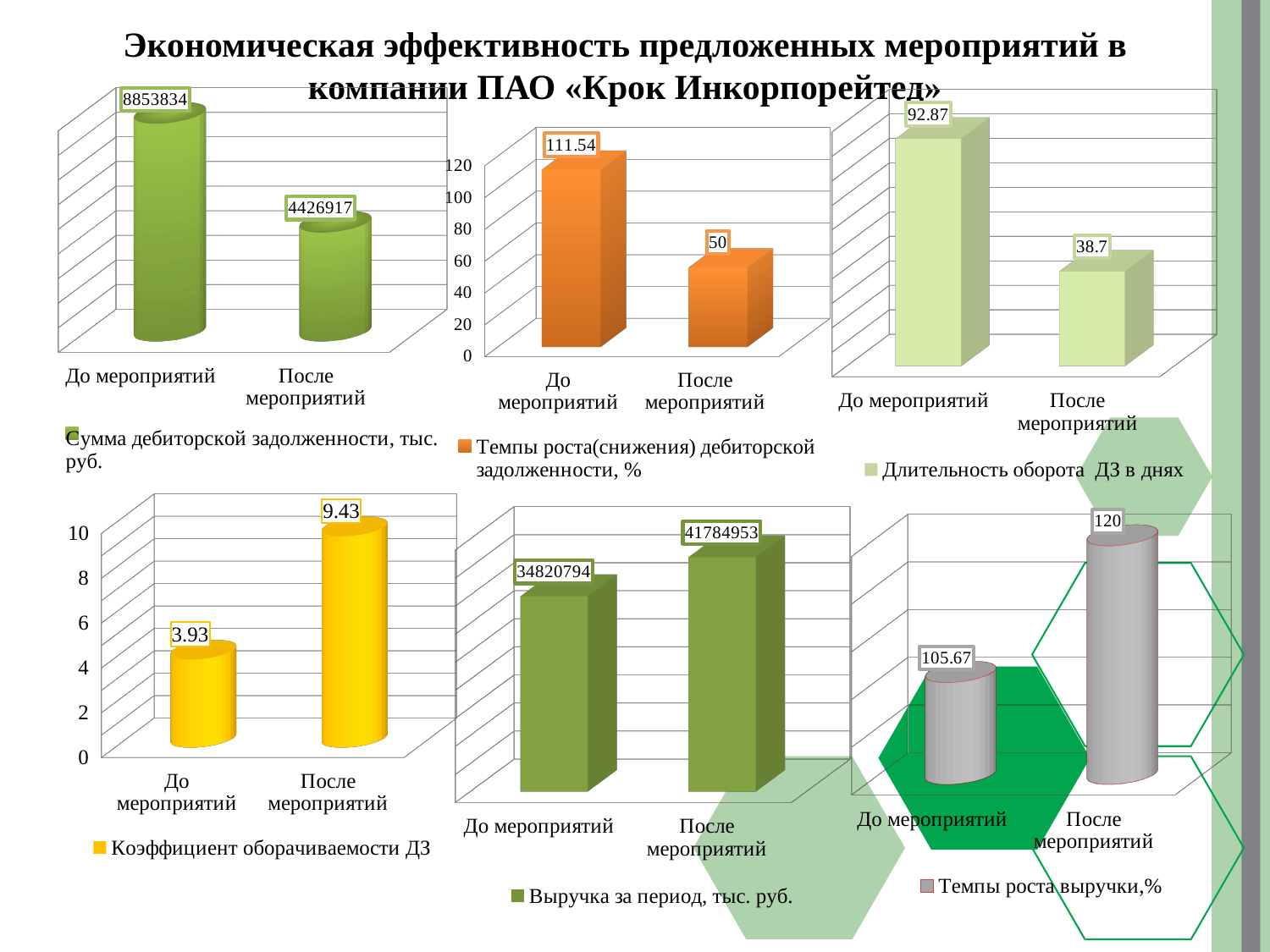
In the chart 'Коэффициент оборачиваемости ДЗ', what is the value for 'После мероприятий'? 9.43 In the chart 'Коэффициент оборачиваемости ДЗ', do the values rise or fall from 'До мероприятий' to 'После мероприятий'? rise In the chart 'Темпы роста(снижения) дебиторской задолженности, %', what is the value for 'После мероприятий'? 50 In the chart 'Выручка за период, тыс. руб.', what is the value for 'После мероприятий'? 41784953 In the chart 'Темпы роста выручки,%', what is the value for 'До мероприятий'? 105.67 In the chart 'Длительность оборота ДЗ в днях', what is the value for 'До мероприятий'? 92.87 In the chart 'Темпы роста(снижения) дебиторской задолженности, %', which category has the higher value? До мероприятий In the chart 'Сумма дебиторской задолженности, тыс. руб.', what is the value for 'До мероприятий'? 8853834 In the chart 'Длительность оборота ДЗ в днях', which category has the lowest value? После мероприятий How many charts are shown on the slide? 6 In the chart 'Сумма дебиторской задолженности, тыс. руб.', what is the difference between the 'До мероприятий' and 'После мероприятий' values? 4426917 In the chart 'Выручка за период, тыс. руб.', which is larger: 'До мероприятий' or 'После мероприятий'? После мероприятий